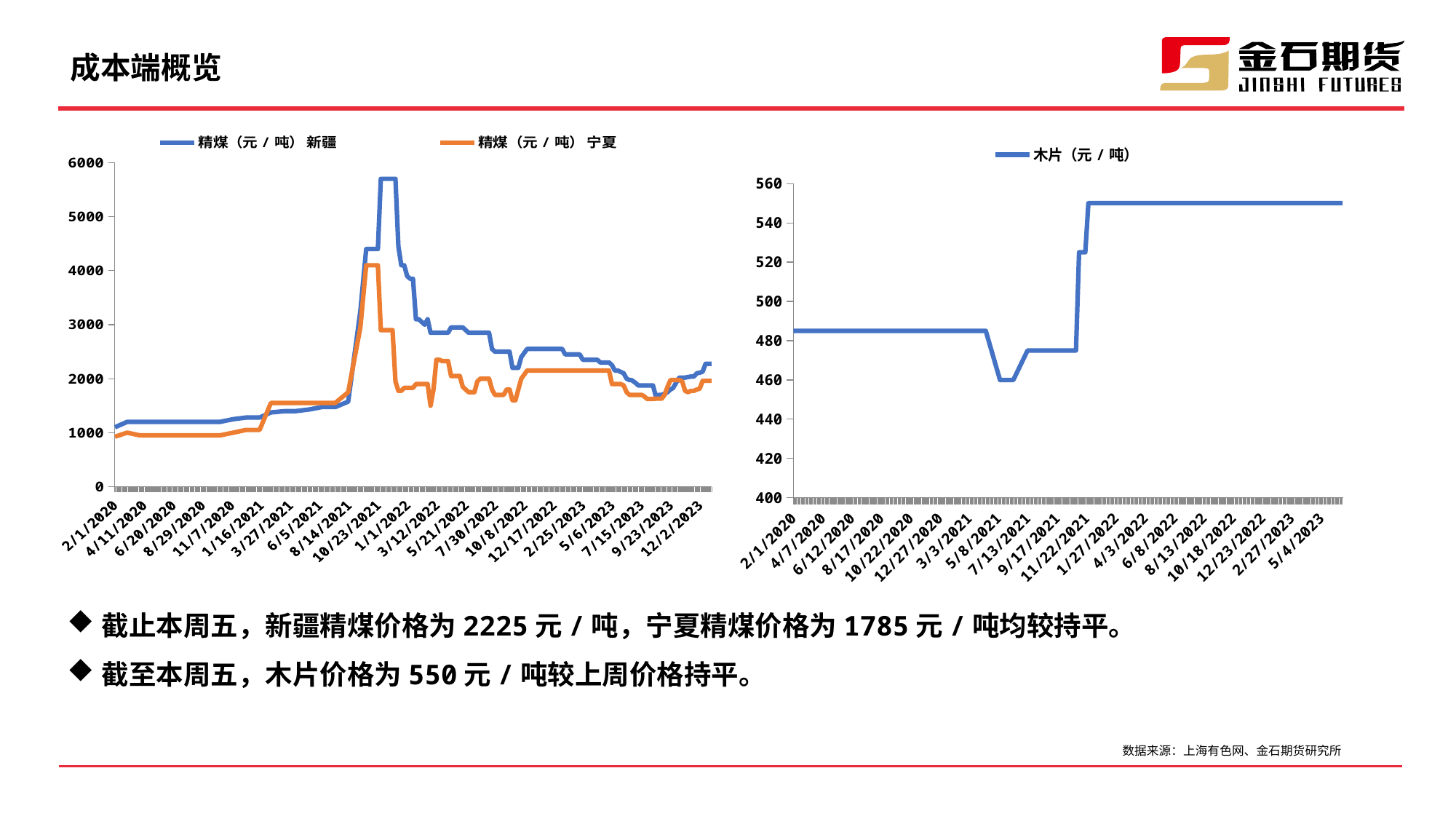
How many series does the legend of the left chart list? 2 In the left chart, is the peak value of the 宁夏 series greater or less than 5000? less In the right chart, is the 木片 value at 2/1/2020 greater or less than 480? greater In the left chart, is the peak value of the 新疆 series greater or less than 5000? greater What are the two legend entries of the left chart? 精煤（元/吨）新疆 and 精煤（元/吨）宁夏 How many series does the legend of the right chart list? 1 What kind of chart is the left chart showing 精煤 prices? line chart In the right chart, does the 木片 price overall rise or fall from the start of the period to the end? rise In the left chart, which series reaches the higher peak, 新疆 or 宁夏? 新疆 What is the legend entry of the right chart? 木片（元/吨）